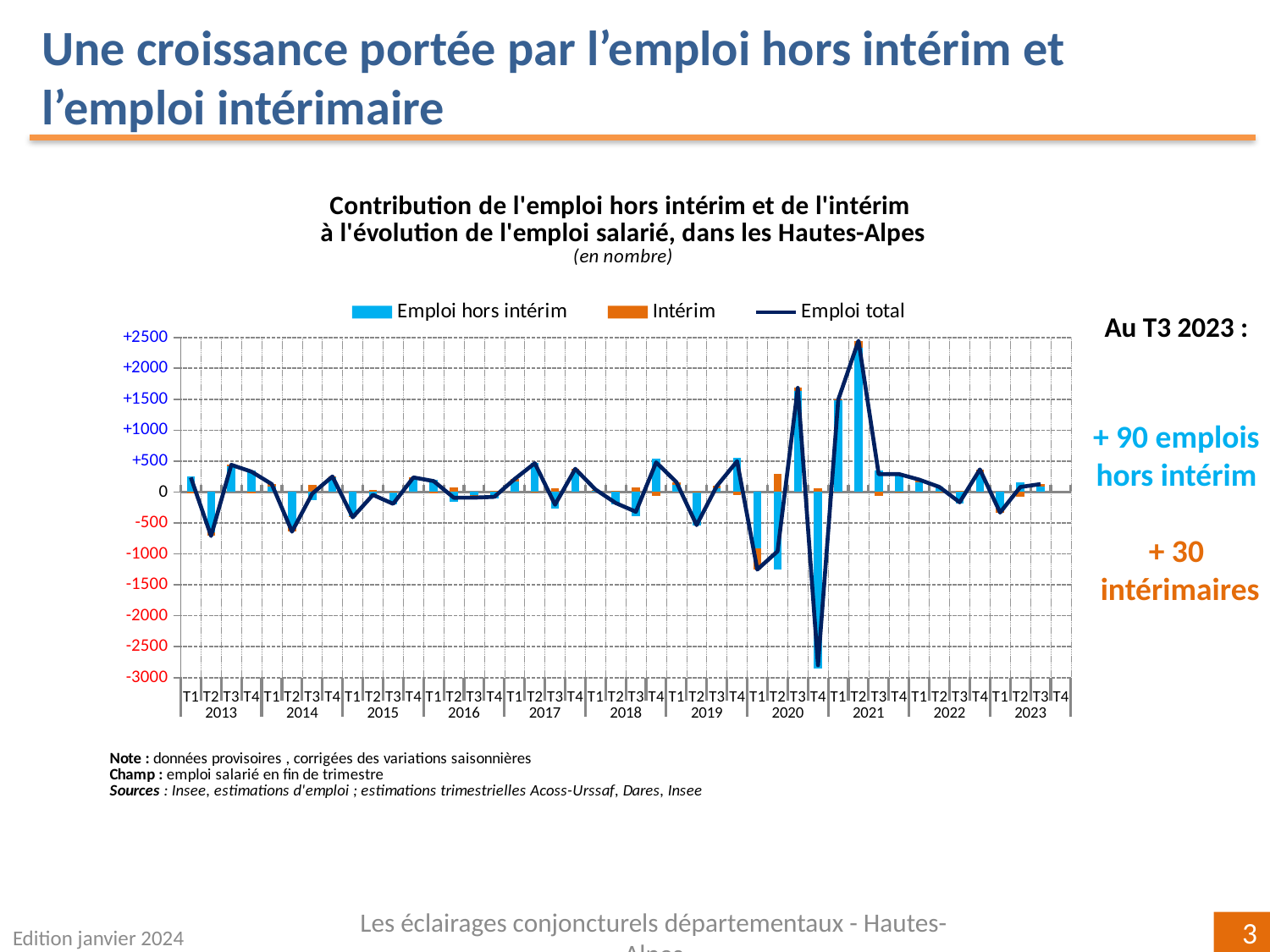
Which series is drawn as a dark line rather than bars? Emploi total Is the Emploi total value at T2 2021 greater or less than +2000? greater How many years are labelled along the x axis? 11 How many series does the legend list? 3 What kind of chart is shown on the slide? combination bar and line chart In which quarter does the Emploi total line reach its lowest point? T4 2020 In which quarter does the Emploi total line reach its highest point? T2 2021 What are the three series named in the legend? Emploi hors intérim, Intérim, Emploi total Is the Emploi total value at T4 2020 greater or less than -2500? less According to the slide, what is the value for Intérim at T3 2023? + 30 According to the slide, what is the value for Emploi hors intérim at T3 2023? + 90 Is the Emploi hors intérim value at T2 2020 greater or less than -1000? less